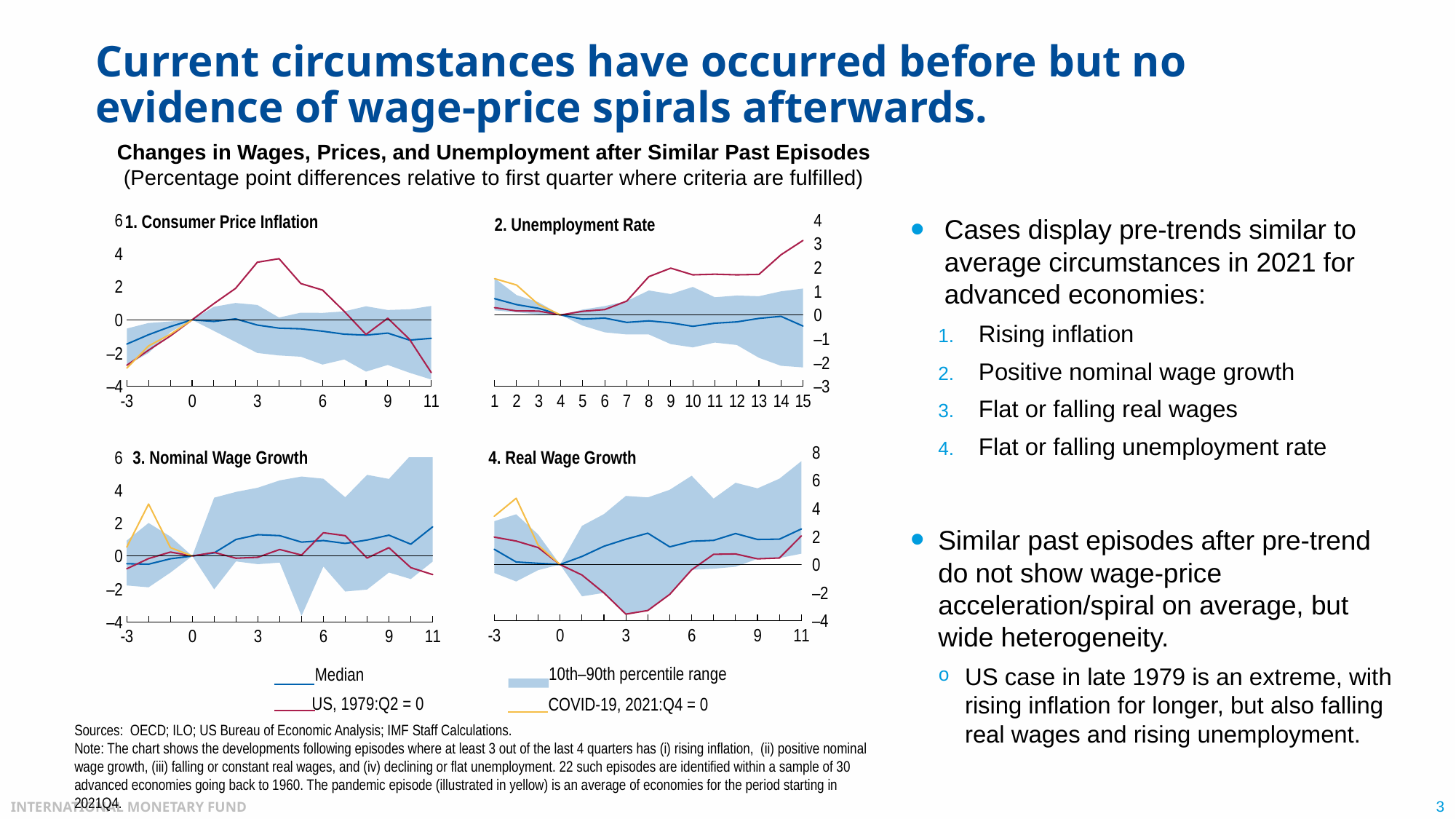
In the '1. Consumer Price Inflation' chart, is the value of the US, 1979:Q2 = 0 line at quarter 11 greater or less than -2? less In the '2. Unemployment Rate' chart, at quarter 15, which is higher: the Median line or the US, 1979:Q2 = 0 line? US, 1979:Q2 = 0 How many entries does the shared legend below the charts list? 4 In the '1. Consumer Price Inflation' chart, is the value of the US, 1979:Q2 = 0 line at quarter 4 greater or less than 2? greater In the '1. Consumer Price Inflation' chart, at quarter 4, which is higher: the Median line or the US, 1979:Q2 = 0 line? US, 1979:Q2 = 0 In the '2. Unemployment Rate' chart, is the value of the US, 1979:Q2 = 0 line at quarter 15 greater or less than 2? greater In the '2. Unemployment Rate' chart, does the US, 1979:Q2 = 0 line rise or fall between quarter 4 and quarter 15? rise According to the legend, what does the shaded blue band in each chart represent? 10th–90th percentile range What kind of chart is used in the four panels on this slide? line chart How many panels (charts) are shown under the title 'Changes in Wages, Prices, and Unemployment after Similar Past Episodes'? 4